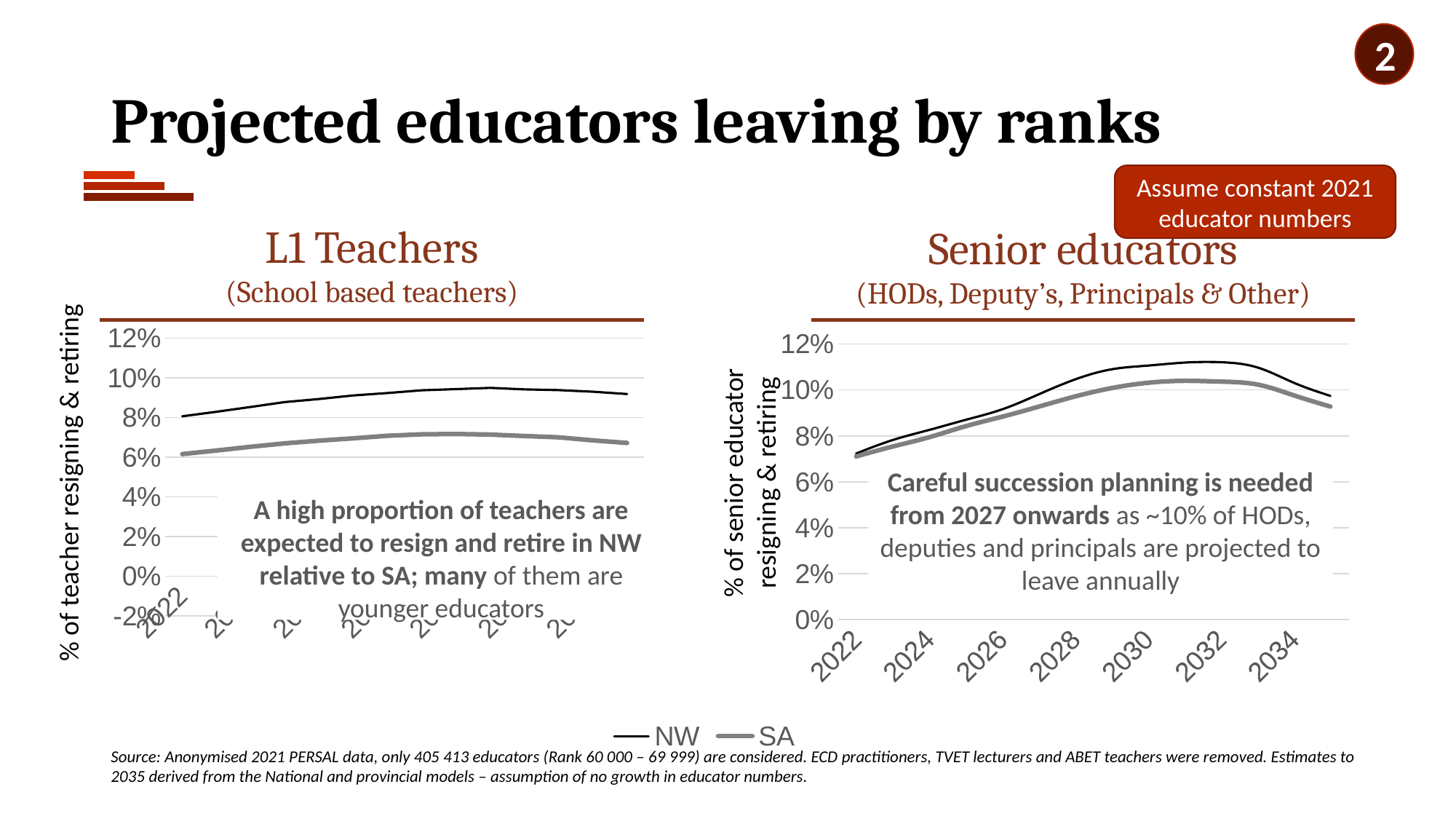
In the Senior educators chart, is the value for SA in 2034 greater or less than 10%? less What is the y-axis label of the Senior educators chart? % of senior educator resigning & retiring In the L1 Teachers chart, is the highest value for NW greater or less than 10%? less What kind of chart is the L1 Teachers chart? line chart In the Senior educators chart, which series is higher in 2032, NW or SA? NW In the Senior educators chart, does the NW series rise or fall between 2022 and 2030? rise In the Senior educators chart, is the value for NW in 2032 greater or less than 10%? greater How many series does the legend list for the charts? 2 Which two series are shown in the legend? NW and SA In the L1 Teachers chart, which series is higher throughout, NW or SA? NW